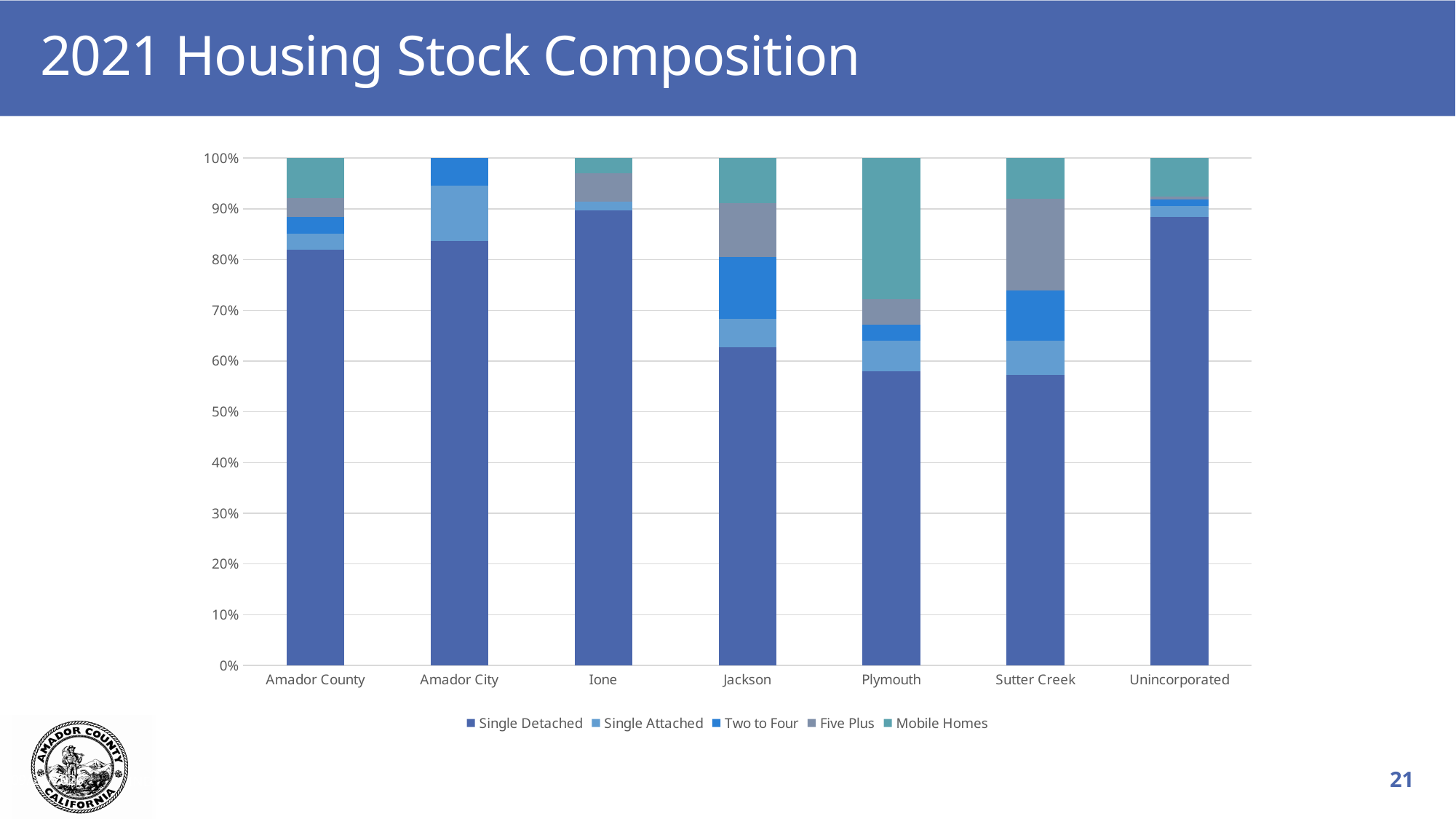
What kind of chart is shown on the slide? Stacked bar chart How many series does the legend list? 5 How many categories (jurisdictions) are shown on the x axis? 7 Which has a larger Mobile Homes share, Plymouth or Jackson? Plymouth Which series is listed last in the legend? Mobile Homes Is the Single Detached share for Ione greater or less than 80%? greater What is the title of the slide? 2021 Housing Stock Composition Which category has the largest Mobile Homes share? Plymouth Is the Single Detached share for Sutter Creek greater or less than 60%? less Which has a larger Single Detached share, Jackson or Plymouth? Jackson Which category has the largest Five Plus share? Sutter Creek Is the Single Detached share for Jackson greater or less than 60%? greater